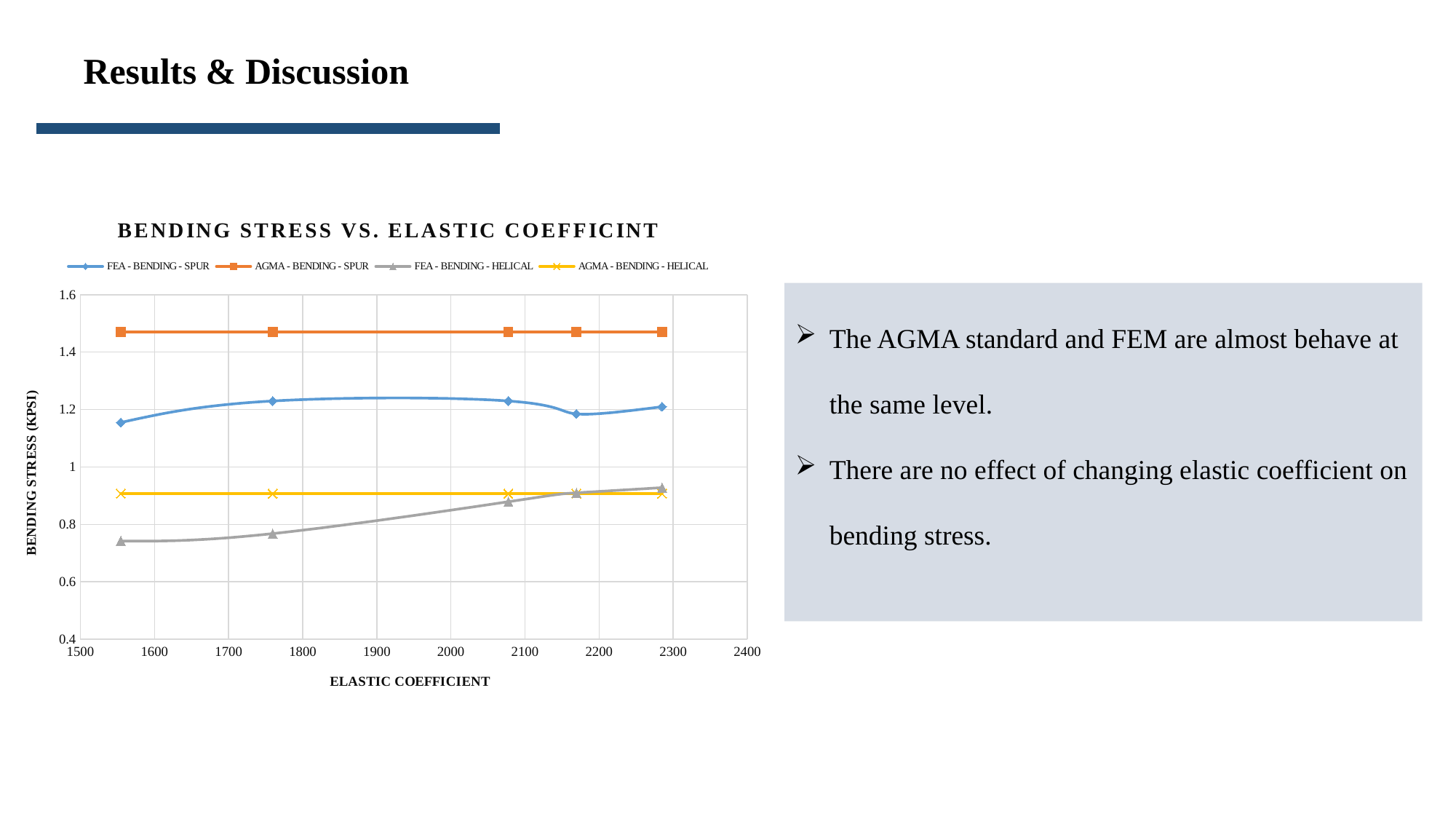
What kind of chart is shown on the slide? Line chart Are the values for AGMA - BENDING - SPUR greater or less than 1.4? greater Do the values for FEA - BENDING - HELICAL rise or fall as the elastic coefficient increases? rise What is the label of the vertical axis? BENDING STRESS (KPSI) How many data points are plotted for the FEA - BENDING - SPUR series? 5 Which series has larger values, FEA - BENDING - SPUR or AGMA - BENDING - SPUR? AGMA - BENDING - SPUR How many series does the legend list? 4 Which series has the highest bending stress values across the chart? AGMA - BENDING - SPUR Are the values for AGMA - BENDING - HELICAL greater or less than 1? less Which series has the lowest bending stress value at the leftmost elastic coefficient point? FEA - BENDING - HELICAL What is the title of the chart? BENDING STRESS VS. ELASTIC COEFFICINT Is the first (leftmost) value for FEA - BENDING - HELICAL greater or less than 0.8? less